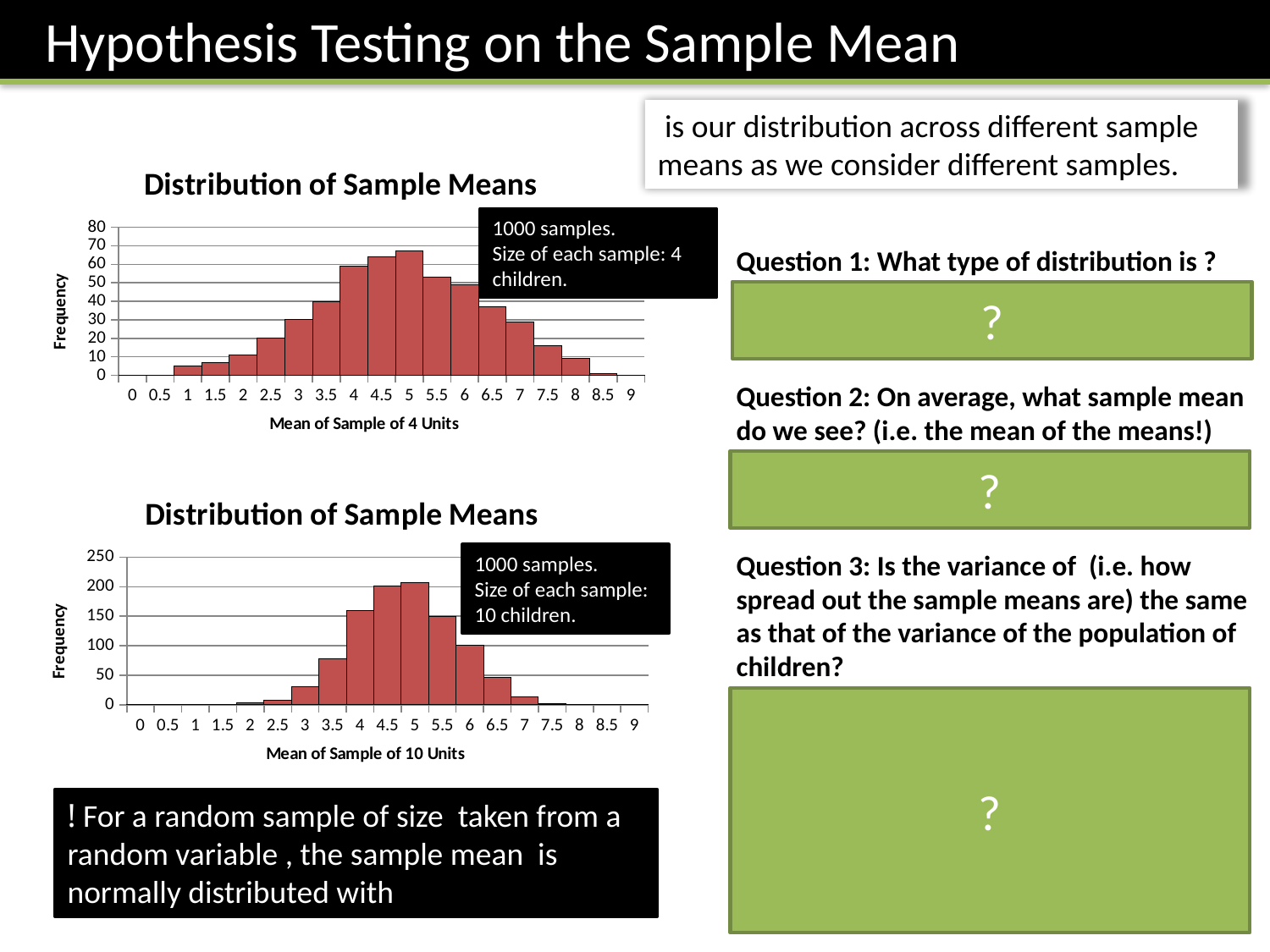
In the top chart (Mean of Sample of 4 Units), is the frequency for a sample mean of 7.5 greater or less than 20? less In the top chart (Mean of Sample of 4 Units), which has the higher frequency: a sample mean of 4 or a sample mean of 7? 4 What kind of chart is the top chart titled 'Distribution of Sample Means' (Mean of Sample of 4 Units)? Bar chart In the top chart (Mean of Sample of 4 Units), is the frequency for a sample mean of 4 greater or less than 50? greater In the top chart (Mean of Sample of 4 Units), do the frequencies rise or fall as the sample mean goes from 1 to 5? rise In the bottom chart (Mean of Sample of 10 Units), is the frequency for a sample mean of 3.5 greater or less than 100? less What is the highest value shown on the y-axis of the bottom chart (Mean of Sample of 10 Units)? 250 In the bottom chart (Mean of Sample of 10 Units), which has the higher frequency: a sample mean of 4.5 or a sample mean of 3? 4.5 What is the x-axis label of the bottom chart? Mean of Sample of 10 Units